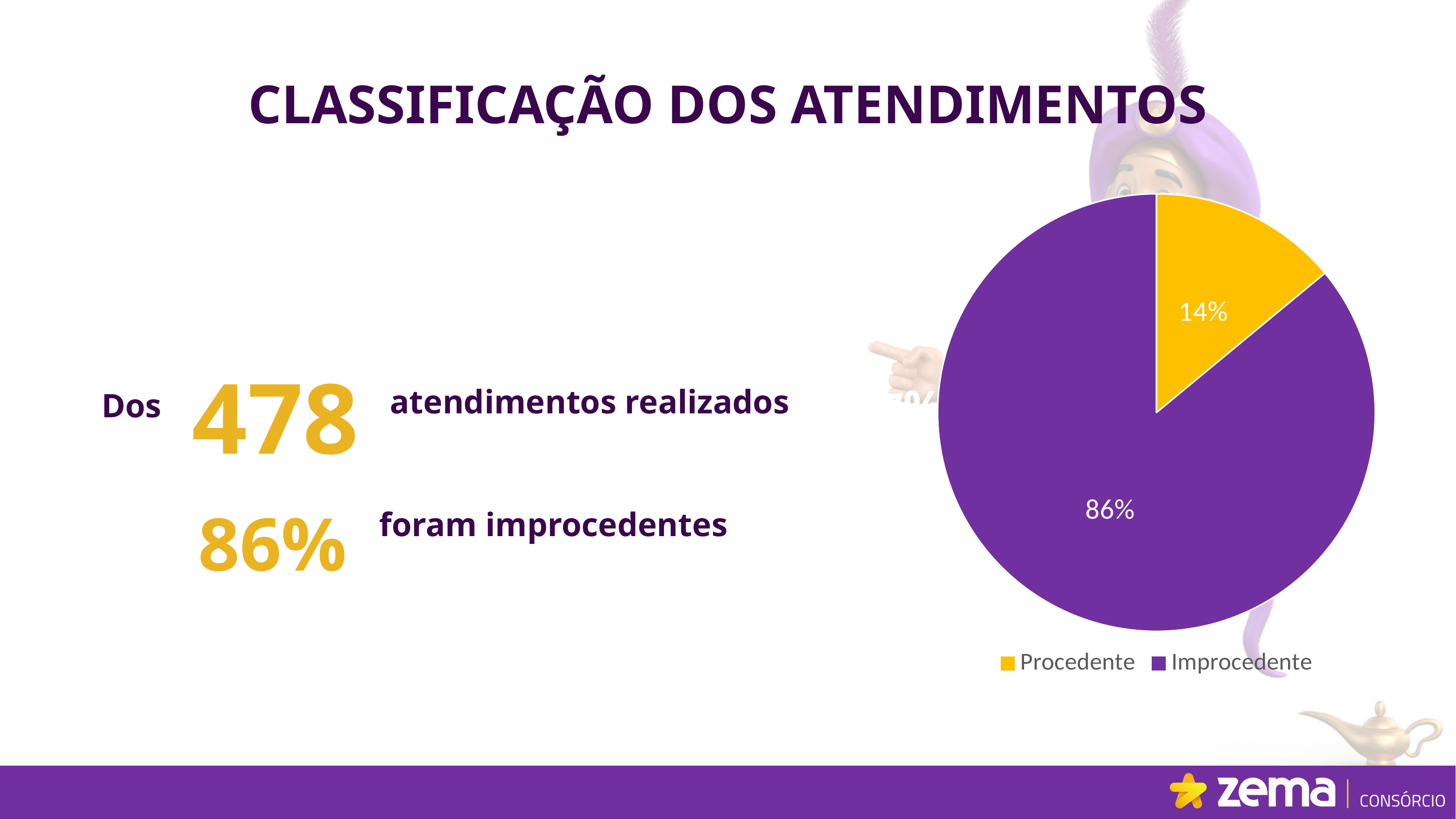
What kind of chart is shown on the slide? pie chart Which category has the largest slice of the pie? Improcedente What colour is the Procedente slice? yellow What is the total number of atendimentos realizados stated on the slide? 478 Which is larger, the Procedente slice or the Improcedente slice? Improcedente What is the difference in percentage points between Improcedente and Procedente? 72 How many entries does the legend list? 2 What colour is the Improcedente slice? purple How many slices does the pie chart have? 2 What share of the pie does Procedente represent? 14% What share of the pie does Improcedente represent? 86% Which category has the smallest slice of the pie? Procedente